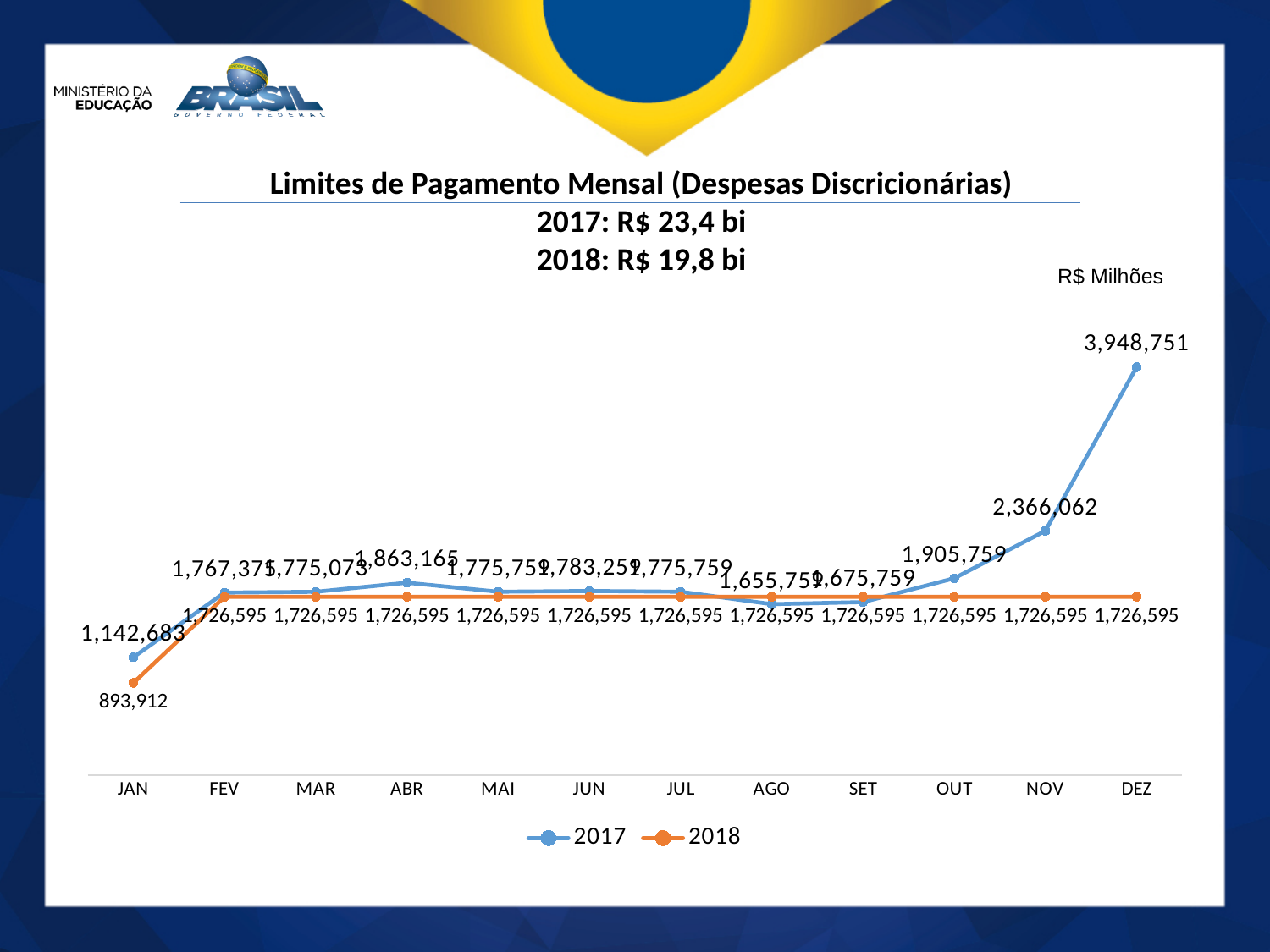
What is the value for 2018 in JAN? 893,912 In JAN, which series has the larger value, 2017 or 2018? 2017 How many series does the legend list? 2 What is the title of the chart? Limites de Pagamento Mensal (Despesas Discricionárias) How many months are shown on the x axis? 12 What is the difference between the 2017 values for DEZ and NOV? 1,582,689 In which month is the 2017 value highest? DEZ What is the value for 2017 in DEZ? 3,948,751 What is the value for 2018 in DEZ? 1,726,595 What kind of chart is shown on the slide? line chart What is the value for 2017 in ABR? 1,863,165 In which month is the 2017 value lowest? JAN